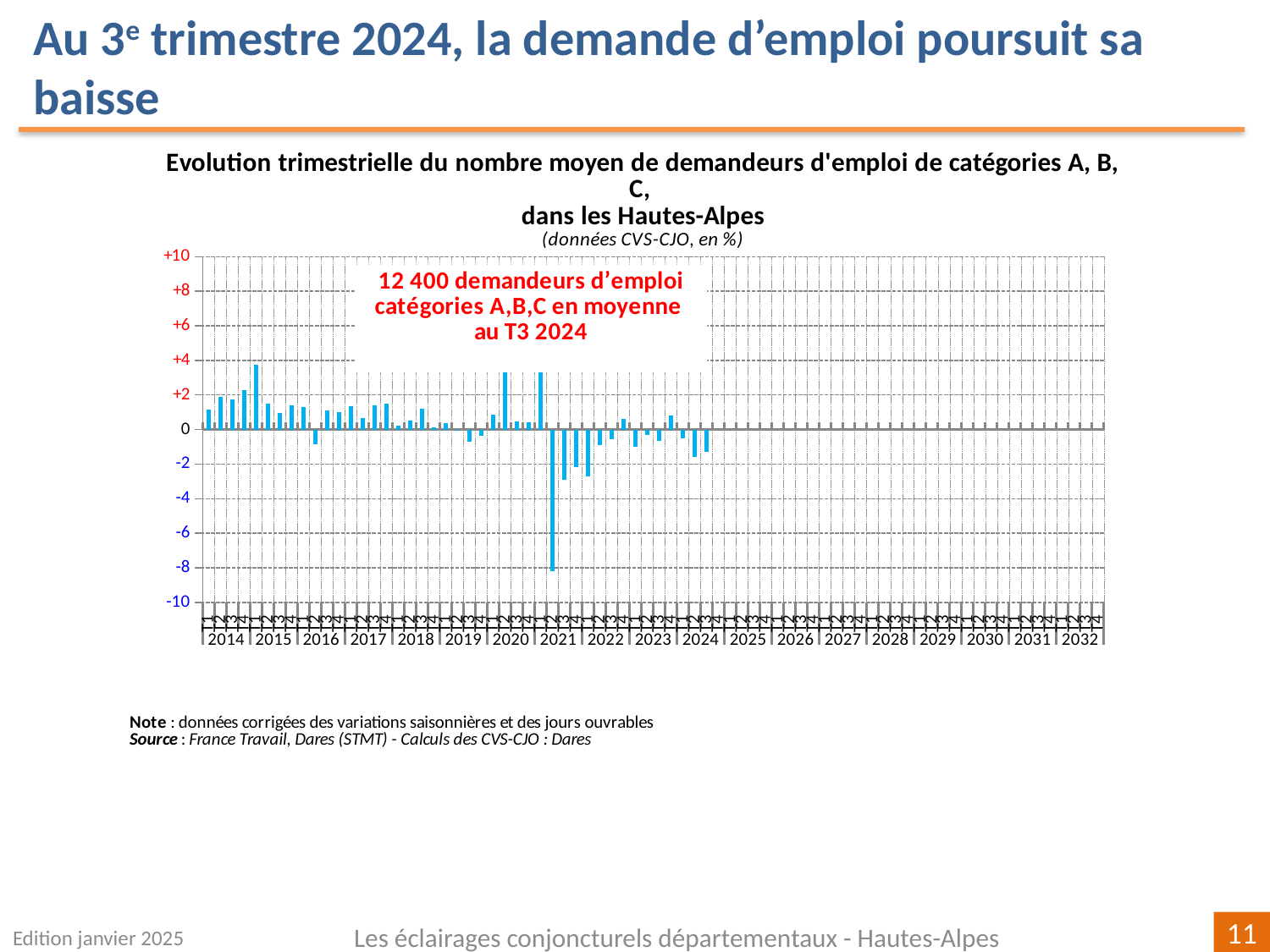
What kind of chart is shown on the slide? Bar chart In which year does the lowest bar of the chart occur? 2021 What is the title of the chart? Evolution trimestrielle du nombre moyen de demandeurs d'emploi de catégories A, B, C, dans les Hautes-Alpes According to the red annotation on the chart, how many demandeurs d'emploi catégories A,B,C were there on average in T3 2024? 12 400 Are the bars in 2014 mostly positive or negative? Positive Is the value of the tallest positive bar in 2015 greater or less than +2? greater Is the value for the second quarter of 2020 greater or less than +2? greater What are the minimum and maximum values shown on the vertical axis? -10 and +10 Is the value for the last plotted quarter of 2024 greater or less than 0? less How many years are labelled along the horizontal axis? 19